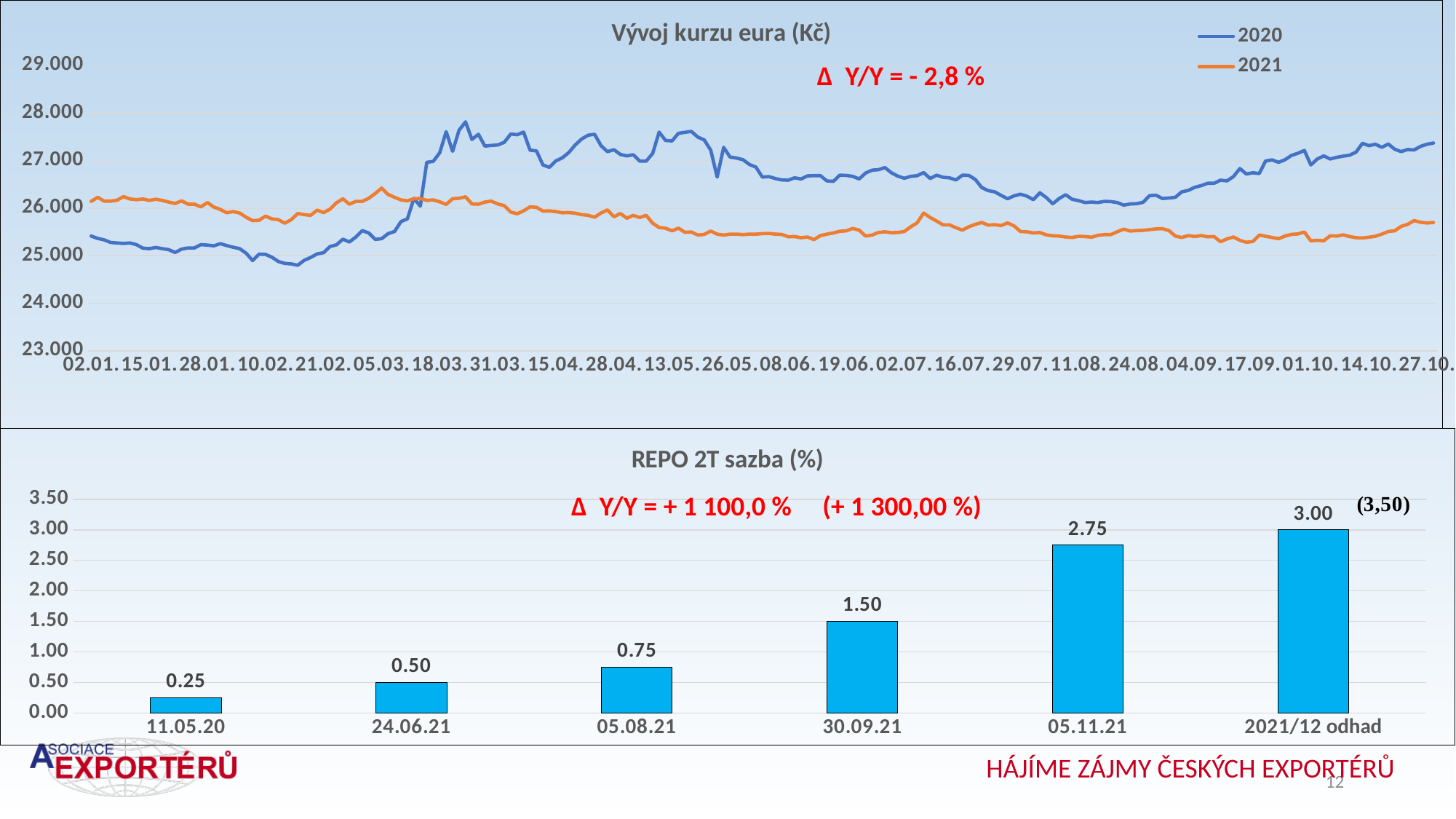
In the chart titled 'REPO 2T sazba (%)', which is larger: the value for 24.06.21 or the value for 05.08.21? 05.08.21 In the chart titled 'REPO 2T sazba (%)', what is the value for 2021/12 odhad? 3.00 In the chart titled 'REPO 2T sazba (%)', what is the difference between the values for 05.11.21 and 30.09.21? 1.25 In the chart titled 'REPO 2T sazba (%)', what is the value for 11.05.20? 0.25 In the chart titled 'REPO 2T sazba (%)', which category has the lowest value? 11.05.20 In the chart titled 'REPO 2T sazba (%)', how many bars are shown? 6 In the chart titled 'REPO 2T sazba (%)', do the values rise or fall from left to right? rise How many series does the legend of the top chart 'Vývoj kurzu eura (Kč)' list? 2 What kind of chart is the top chart titled 'Vývoj kurzu eura (Kč)'? line chart In the chart titled 'REPO 2T sazba (%)', what is the value for 30.09.21? 1.50 What kind of chart is the bottom chart titled 'REPO 2T sazba (%)'? bar chart In the chart titled 'REPO 2T sazba (%)', which category has the highest value? 2021/12 odhad